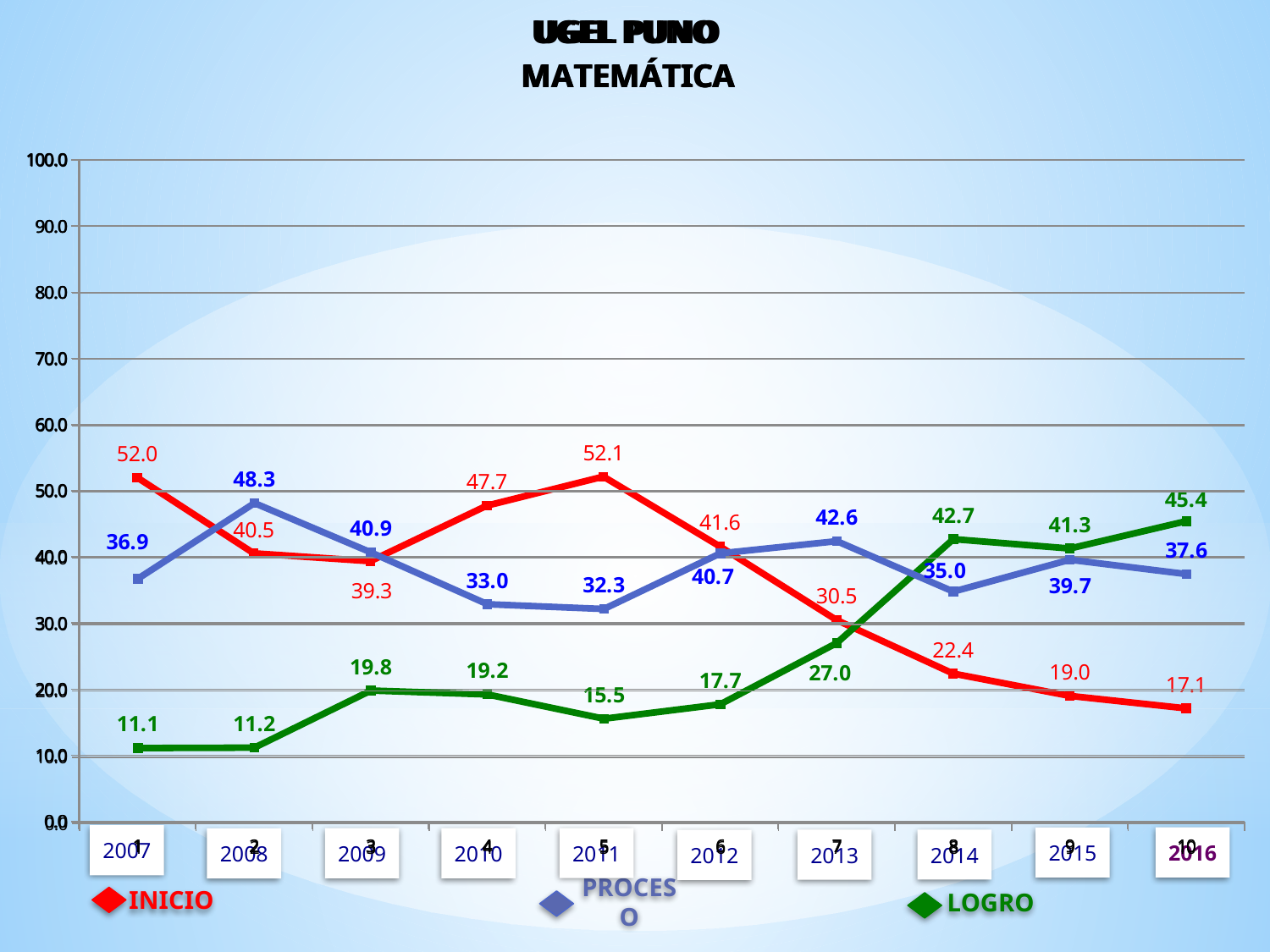
In which year is the INICIO series lowest? 2016 What is the value for INICIO in 2007? 52.0 Does the LOGRO series generally rise or fall from 2007 to 2016? Rise Which is larger in 2014, LOGRO or PROCESO? LOGRO In which year is the LOGRO series highest? 2016 What is the value for PROCESO in 2011? 32.3 What is the value for LOGRO in 2016? 45.4 How many series does the legend list? 3 How many years are shown on the x axis? 10 In which year is the PROCESO series highest? 2008 What is the difference between the INICIO value in 2007 and the INICIO value in 2016? 34.9 What kind of chart is shown on the slide? Line chart